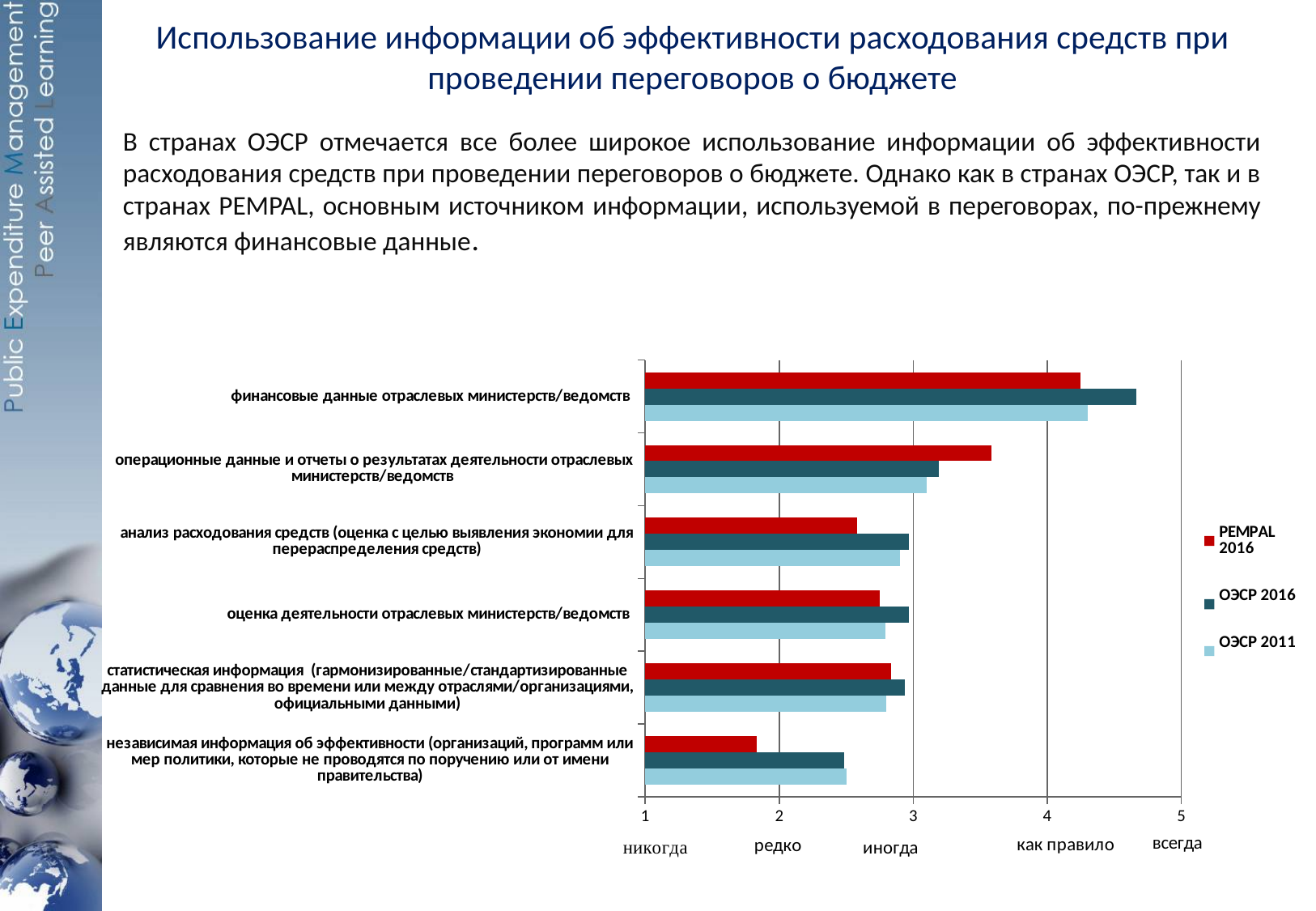
Which category has the highest value for the ОЭСР 2016 series? финансовые данные отраслевых министерств/ведомств Is the PEMPAL 2016 value for анализ расходования средств greater or less than 3? less What kind of chart is shown on the slide? bar chart Which series is shown in red in the chart legend? PEMPAL 2016 Is the PEMPAL 2016 value for финансовые данные отраслевых министерств/ведомств greater or less than 4? greater Is the PEMPAL 2016 value for независимая информация об эффективности greater or less than 2? less How many categories are plotted on the chart? 6 For финансовые данные отраслевых министерств/ведомств, which series has the larger value: PEMPAL 2016 or ОЭСР 2016? ОЭСР 2016 How many series does the chart legend list? 3 For операционные данные и отчеты о результатах деятельности отраслевых министерств/ведомств, which series has the larger value: PEMPAL 2016 or ОЭСР 2016? PEMPAL 2016 Which category has the highest value for the PEMPAL 2016 series? финансовые данные отраслевых министерств/ведомств Which category has the lowest value for the PEMPAL 2016 series? независимая информация об эффективности (организаций, программ или мер политики, которые не проводятся по поручению или от имени правительства)